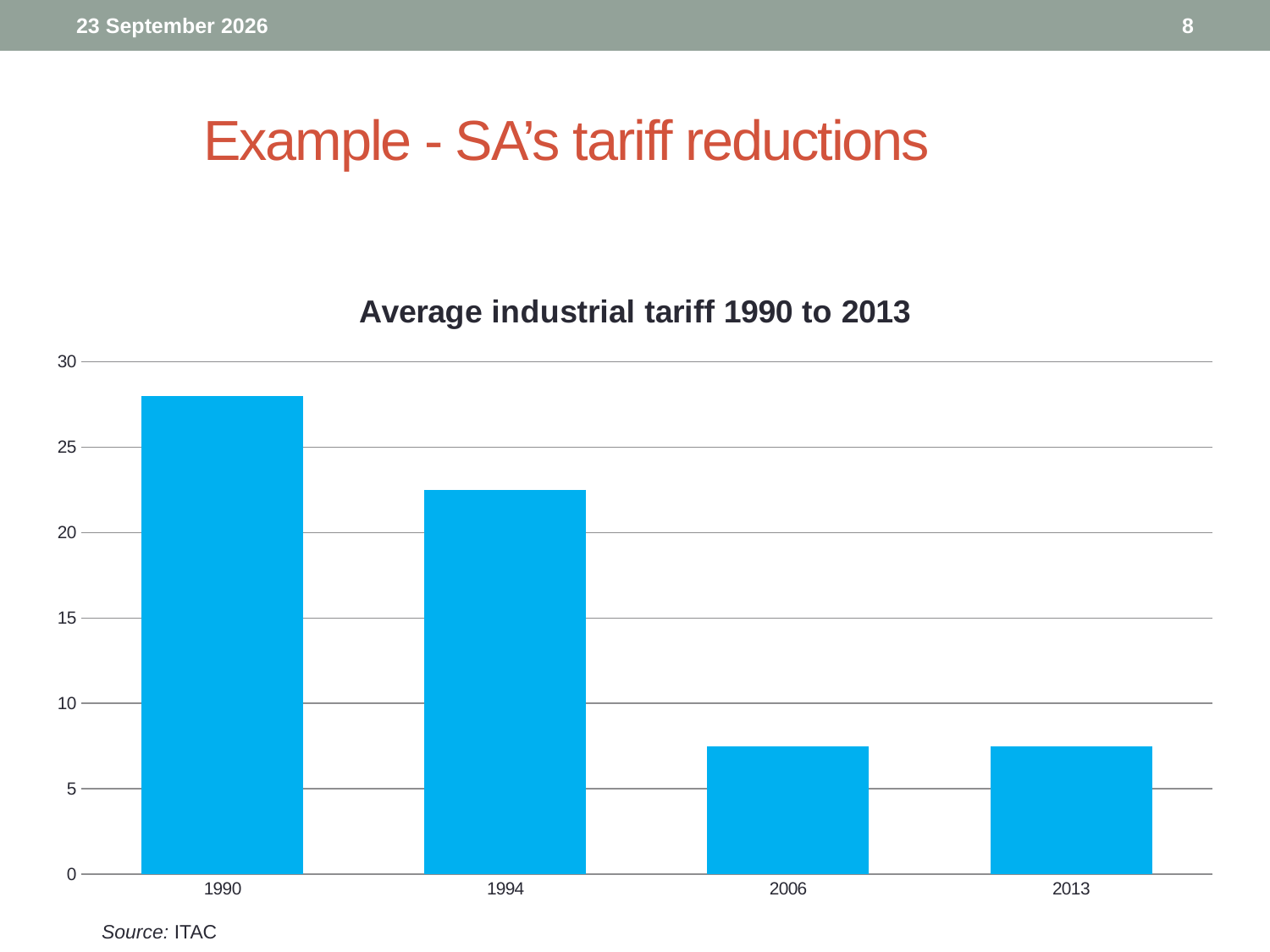
What is the title of the chart? Average industrial tariff 1990 to 2013 Is the value for 1990 greater or less than 25? greater Which year has the highest average industrial tariff in the chart? 1990 Which is larger, the value for 1990 or the value for 1994? 1990 Is the value for 2013 greater or less than 5? greater Is the value for 2006 greater or less than 10? less How many years (categories) are shown on the x axis of the chart? 4 What source is cited below the chart? ITAC What kind of chart is shown on the slide? Bar chart Do the values rise or fall from 1990 to 2013 along the x axis? Fall